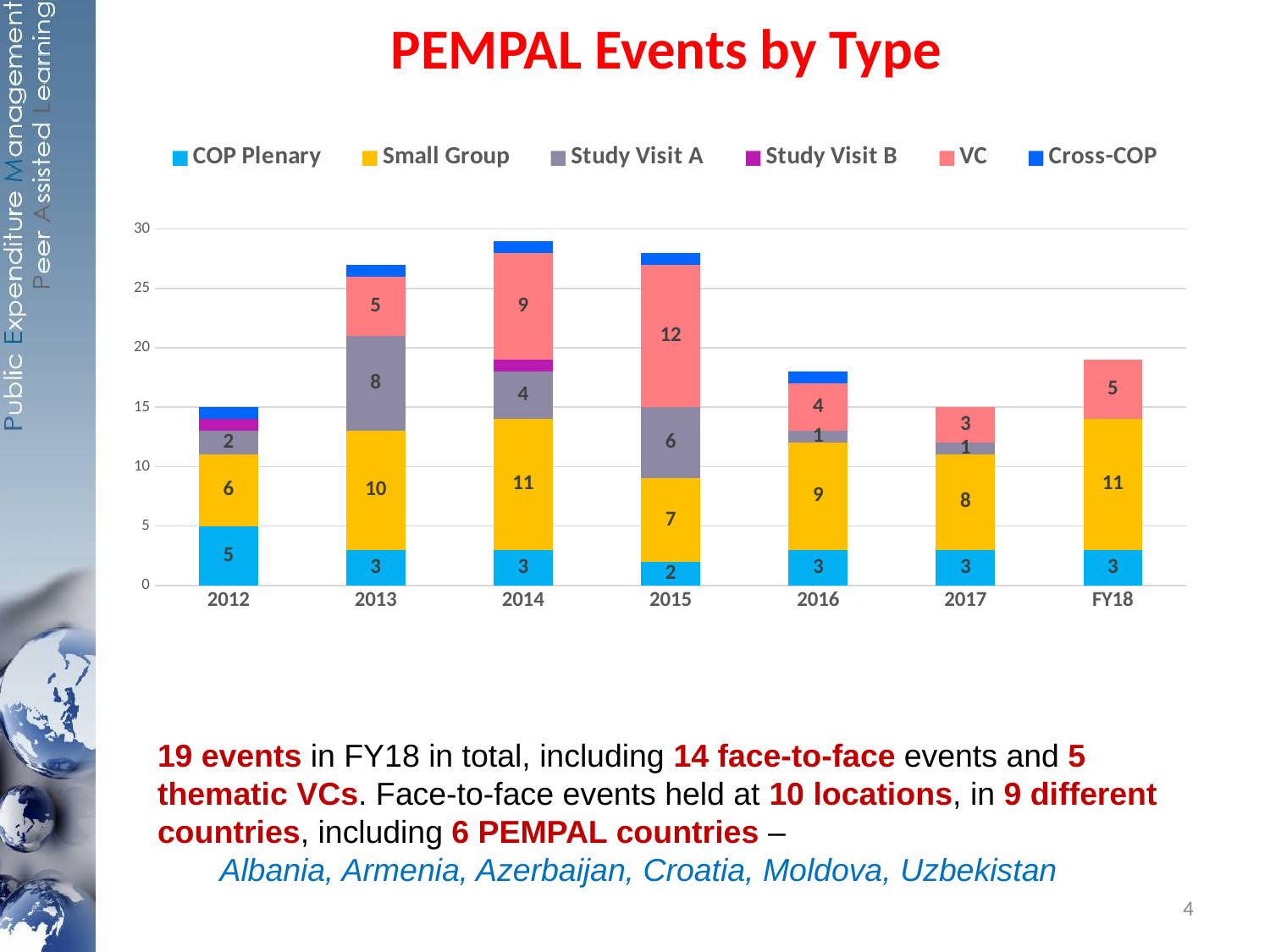
What is the value for COP Plenary in 2012? 5 In which year is the VC value highest? 2015 What is the total of the FY18 stacked bar? 19 How many years (categories) are shown on the x axis? 7 What is the value for VC in 2015? 12 Is the total height of the 2014 bar greater or less than 25? greater Which year has the larger Study Visit A value, 2013 or 2014? 2013 What is the difference between the Small Group value in FY18 and in 2017? 3 How many series does the legend list? 6 What kind of chart is shown on the slide? stacked bar chart What is the value for Small Group in 2013? 10 In which year is the COP Plenary value lowest? 2015